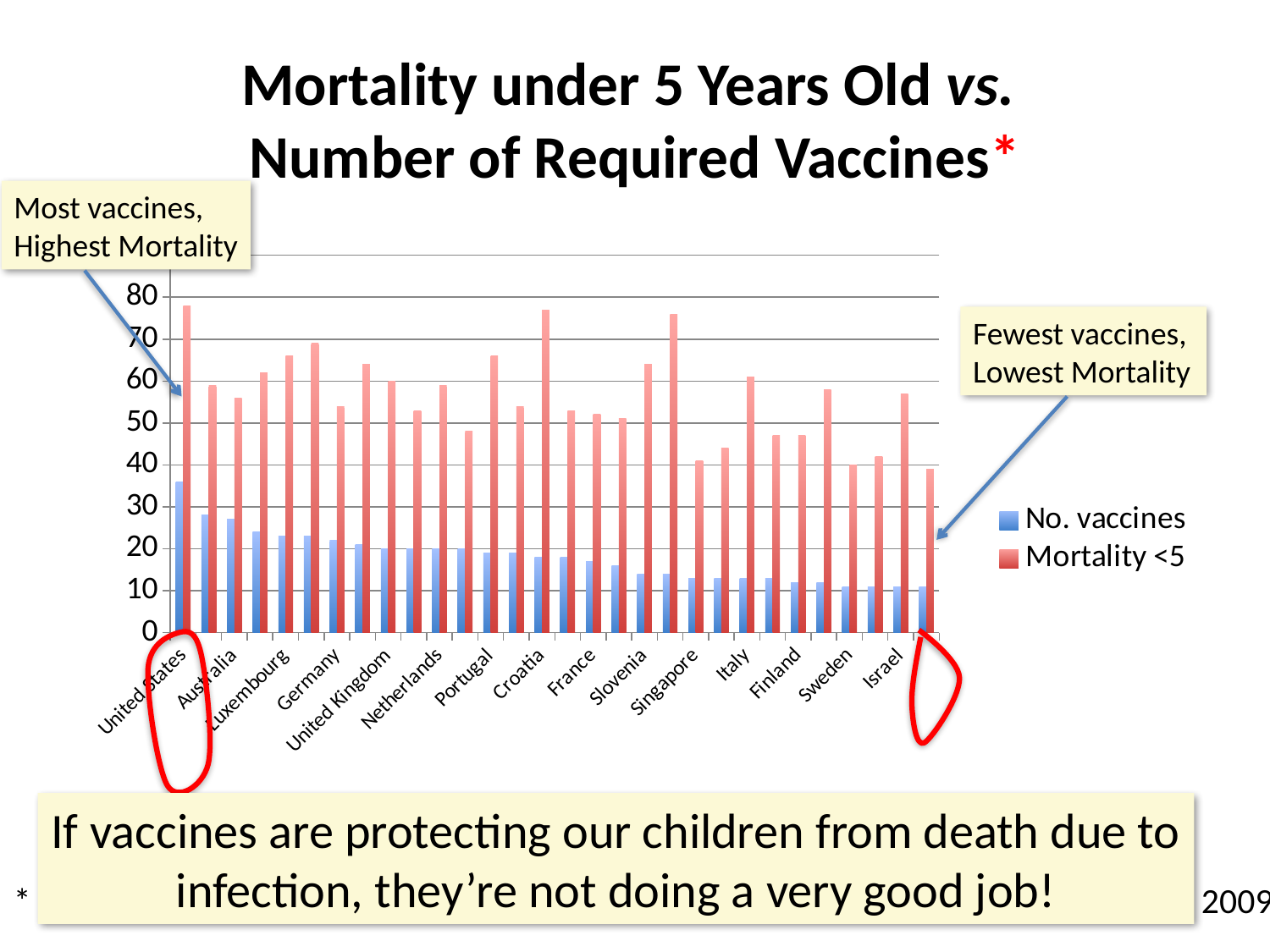
Is the Mortality <5 value for United States greater or less than 70? greater What are the two series named in the chart's legend? No. vaccines and Mortality <5 Do the No. vaccines values generally rise or fall moving from left to right along the x axis? fall Is the No. vaccines value for United States greater or less than 30? greater Is the Mortality <5 value for Singapore greater or less than 50? less Which is larger, the Mortality <5 value for United States or for Israel? United States What kind of chart is shown on the slide? bar chart How many series does the chart's legend list? 2 Which country has the highest value for No. vaccines? United States Which is larger, the No. vaccines value for Australia or for Sweden? Australia What is the title of the chart on the slide? Mortality under 5 Years Old vs. Number of Required Vaccines